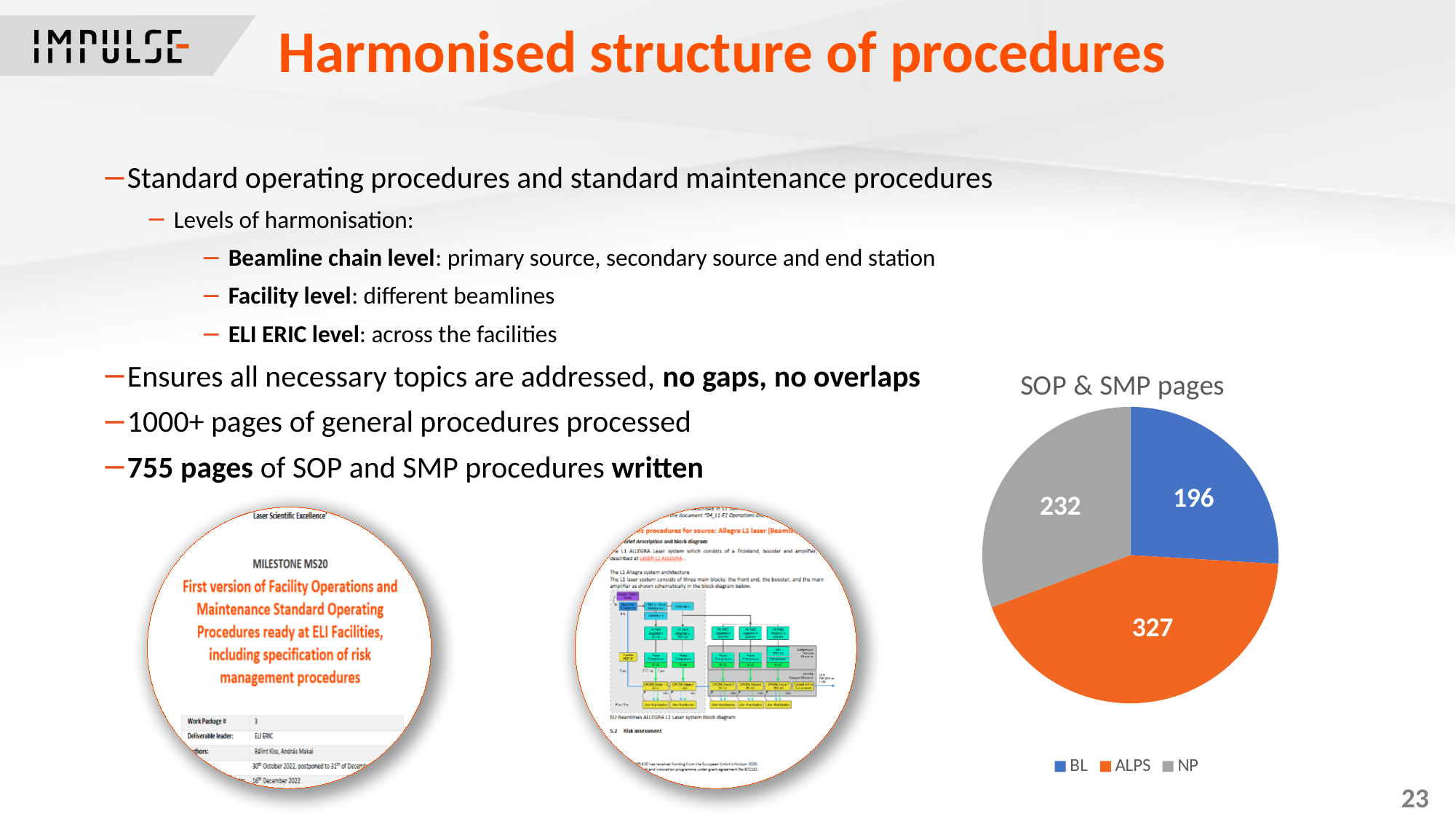
Which is larger, the value for NP or the value for BL? NP Which category has the largest slice in the pie chart? ALPS How many pages does the chart show for NP? 232 What is the title of the chart? SOP & SMP pages How many pages does the chart show for BL? 196 How many pages does the chart show for ALPS? 327 What is the total of all slices in the pie chart? 755 Which category has the smallest slice in the pie chart? BL How many categories does the pie chart show? 3 Which colour represents ALPS in the pie chart? Orange What type of chart is shown on the slide? Pie chart What is the difference between the ALPS and BL values? 131